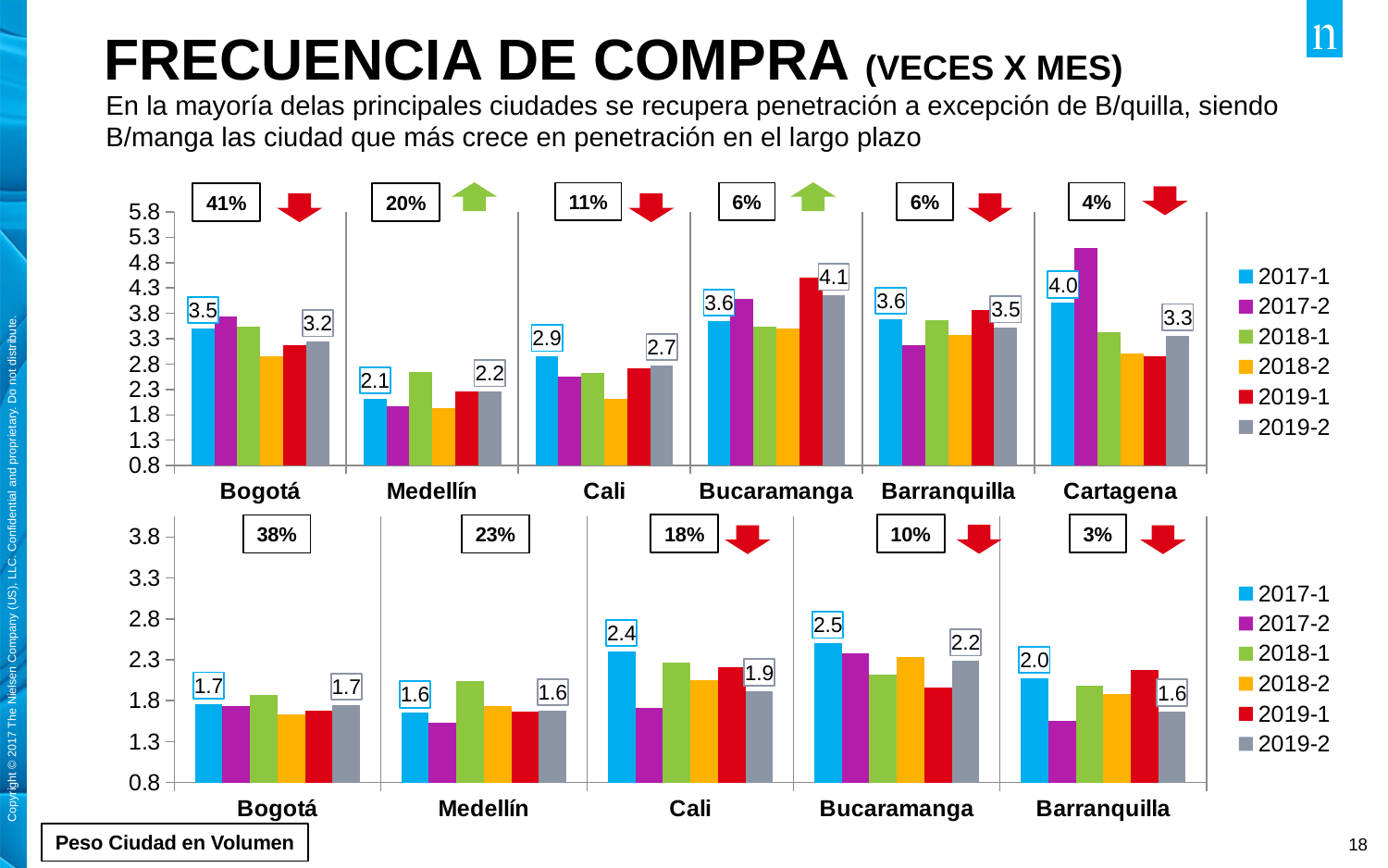
How many cities are shown on the x axis of the bottom chart? 5 In the top chart, what is the 2019-2 value for Bucaramanga? 4.1 In the bottom chart, what is the difference between the 2017-1 and 2019-2 values for Cali? 0.5 In the top chart, which is larger for Medellín: the 2017-1 value or the 2019-2 value? 2019-2 In the bottom chart, what is the 2017-1 value for Cali? 2.4 In the bottom chart, what is the 2019-2 value for Bucaramanga? 2.2 In the top chart, what is the 2017-1 value for Bogotá? 3.5 How many series does the legend of the top chart list? 6 What type of chart is the top chart? Bar chart In the top chart, what is the 2017-1 value for Cartagena? 4.0 In the top chart, is the 2019-1 value for Bucaramanga greater or less than 4.3? greater In the top chart, what is the difference between the 2017-1 and 2019-2 values for Cartagena? 0.7